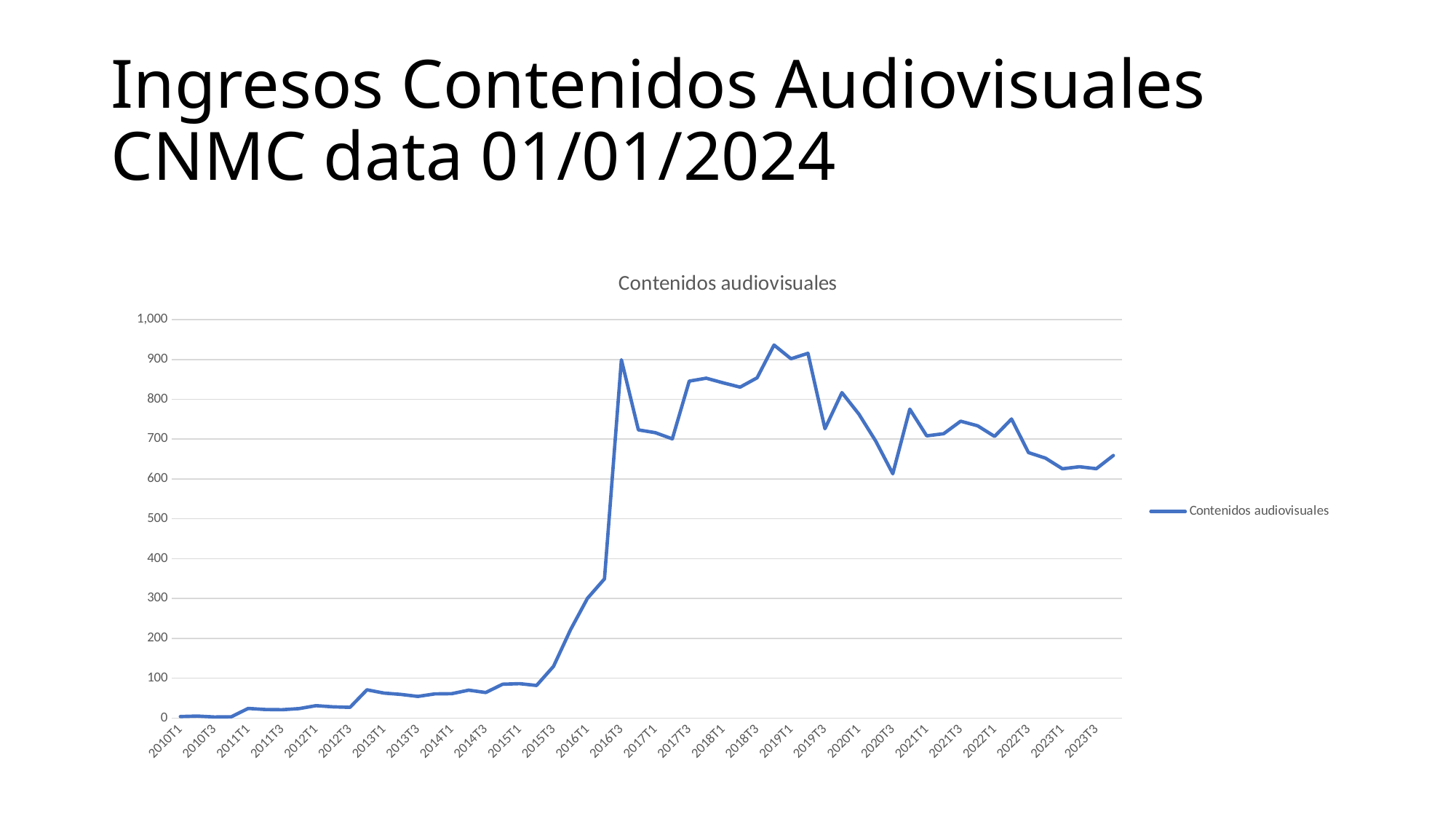
What kind of chart is shown on the slide? line chart Is the value for 2018T3 greater or less than 800? greater How many series does the legend list? 1 What is the title of the chart? Contenidos audiovisuales Is the value for 2015T3 greater or less than 100? greater How many labels are shown on the x axis of the chart? 28 Do the values rise or fall along the x axis from 2010T1 to 2016T3? rise Which is larger, the value for 2016T3 or the value for 2017T1? 2016T3 Is the value for 2020T3 greater or less than 700? less Do the values rise or fall along the x axis from 2019T1 to 2020T3? fall